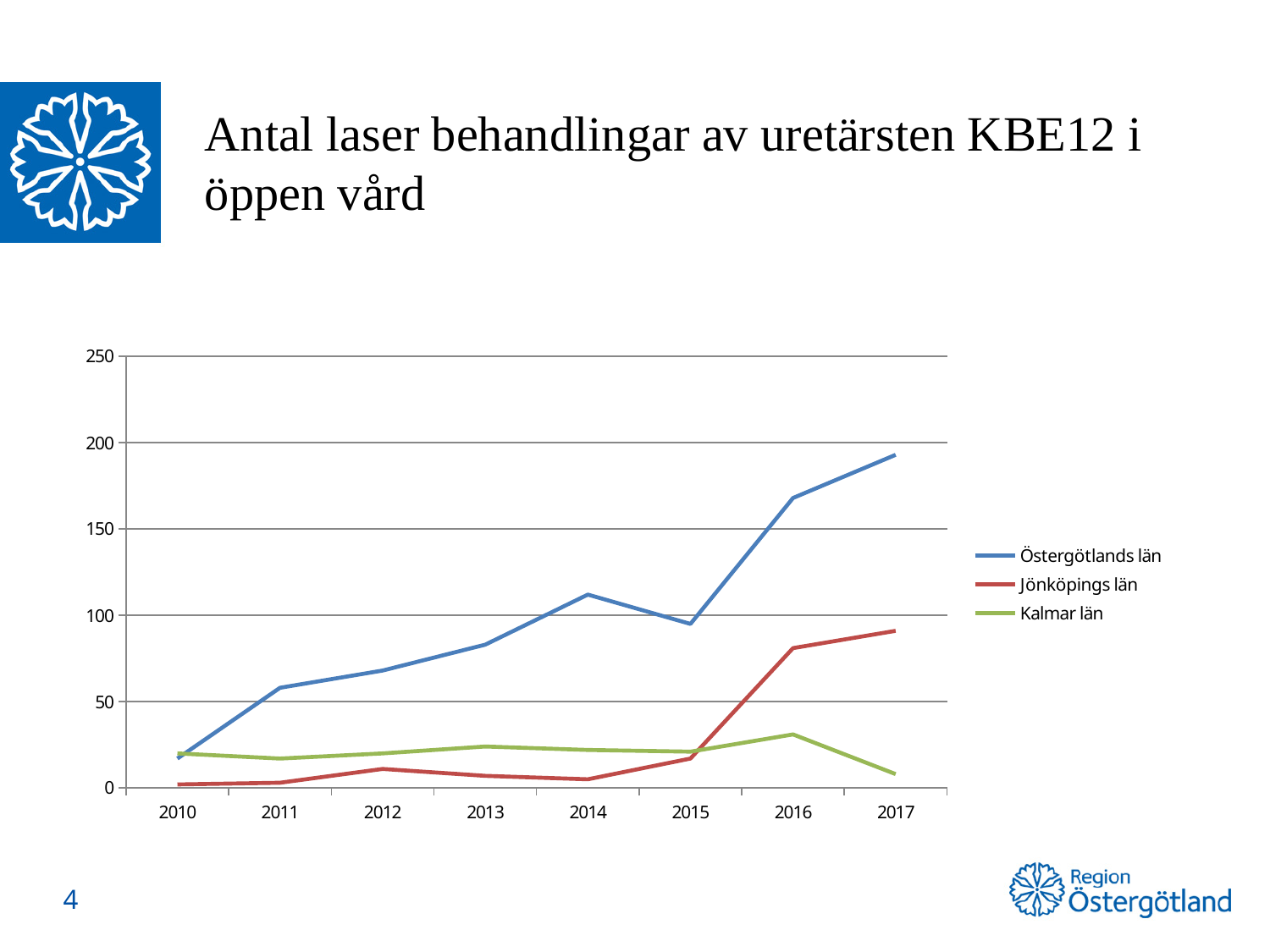
Which series has the highest value in 2016? Östergötlands län Is the value for Kalmar län in 2017 greater or less than 50? less Is the value for Östergötlands län in 2017 greater or less than 150? greater Is the value for Östergötlands län in 2014 greater or less than 100? greater Which series has the higher value in 2017, Östergötlands län or Jönköpings län? Östergötlands län Does the value for Östergötlands län generally rise or fall from 2010 to 2017? rise How many years are shown on the x axis? 8 Which series has the lowest value in 2014? Jönköpings län What kind of chart is shown on the slide? line chart How many series does the legend list? 3 In which year does Östergötlands län reach its highest value? 2017